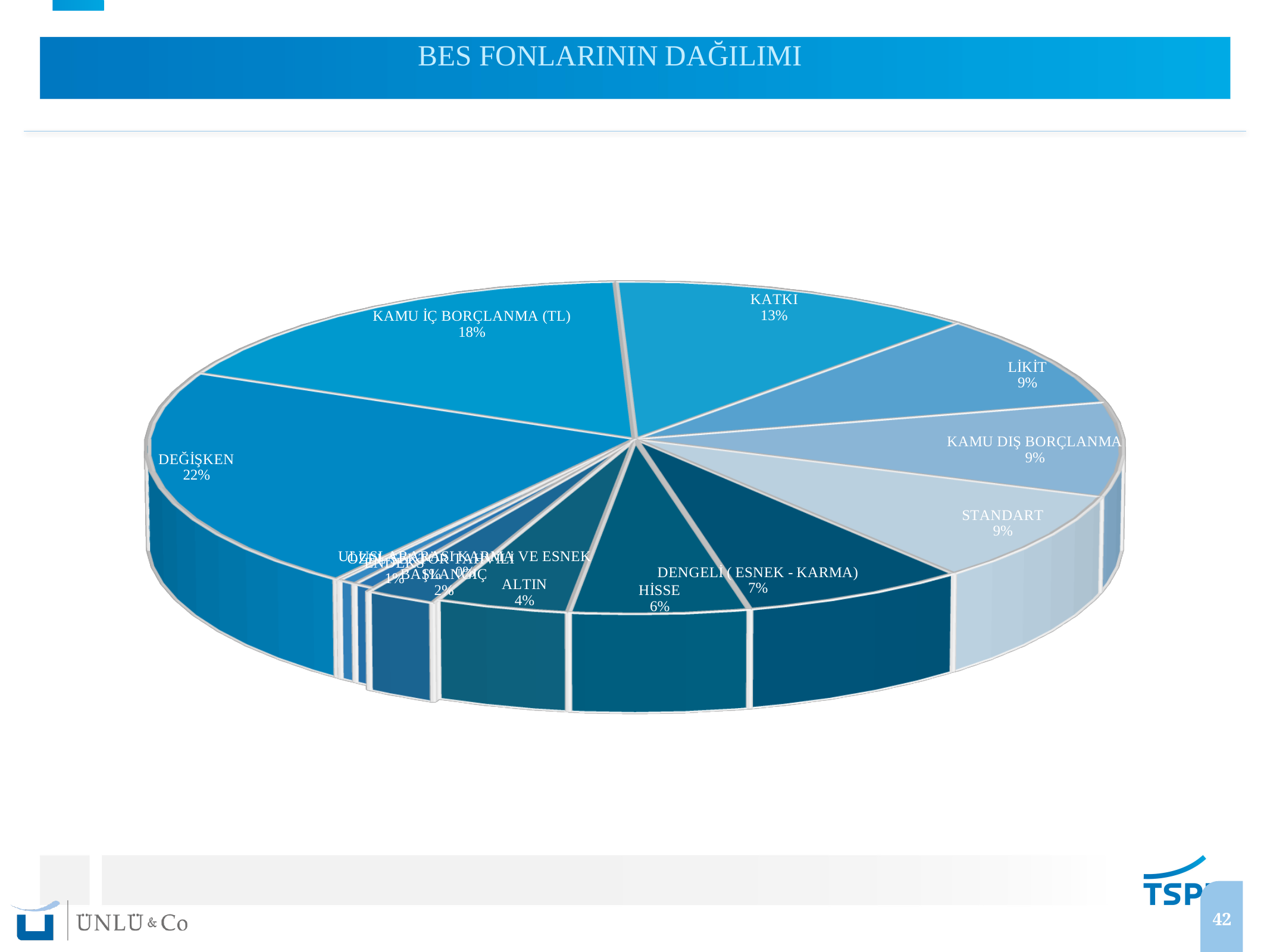
Which has a larger share, KATKI or HİSSE? KATKI Which category has the largest share of the pie? DEĞİŞKEN What is the difference in percentage points between DEĞİŞKEN and KAMU İÇ BORÇLANMA (TL)? 4 What is the combined share of LİKİT, KAMU DIŞ BORÇLANMA and STANDART? 27% What type of chart is shown on the slide? pie chart What share of the pie does DENGELİ ( ESNEK - KARMA) hold? 7% What share of the pie does KATKI hold? 13% What share of the pie does DEĞİŞKEN hold? 22% What share of the pie does HİSSE hold? 6% What share of the pie does KAMU İÇ BORÇLANMA (TL) hold? 18% What is the title of the chart? BES FONLARININ DAĞILIMI What share of the pie does ALTIN hold? 4%